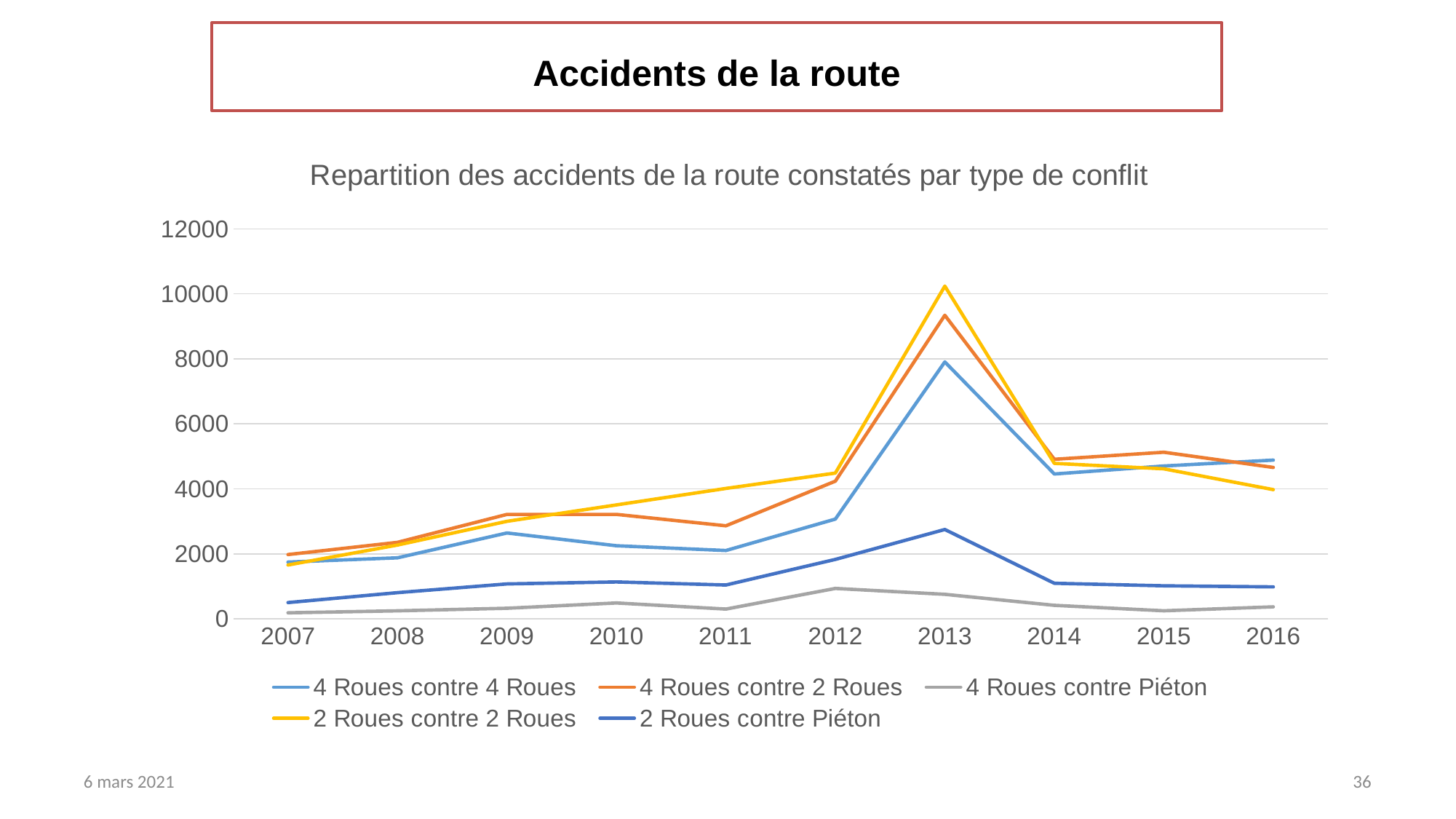
What kind of chart is shown on the slide? Line chart In which year does the series "2 Roues contre 2 Roues" reach its highest value? 2013 What is the title of the chart? Repartition des accidents de la route constatés par type de conflit Is the value for "2 Roues contre 2 Roues" in 2013 greater or less than 10000? greater In 2016, which series is higher: "4 Roues contre 4 Roues" or "2 Roues contre 2 Roues"? 4 Roues contre 4 Roues Between 2013 and 2014, does the series "2 Roues contre 2 Roues" rise or fall? fall How many years are shown on the x axis? 10 Is the value for "4 Roues contre 4 Roues" in 2013 greater or less than 6000? greater In 2013, which series is higher: "4 Roues contre 2 Roues" or "4 Roues contre 4 Roues"? 4 Roues contre 2 Roues Which series has the lowest values throughout the chart? 4 Roues contre Piéton Is the value for "4 Roues contre Piéton" in 2013 greater or less than 2000? less How many series does the legend list? 5